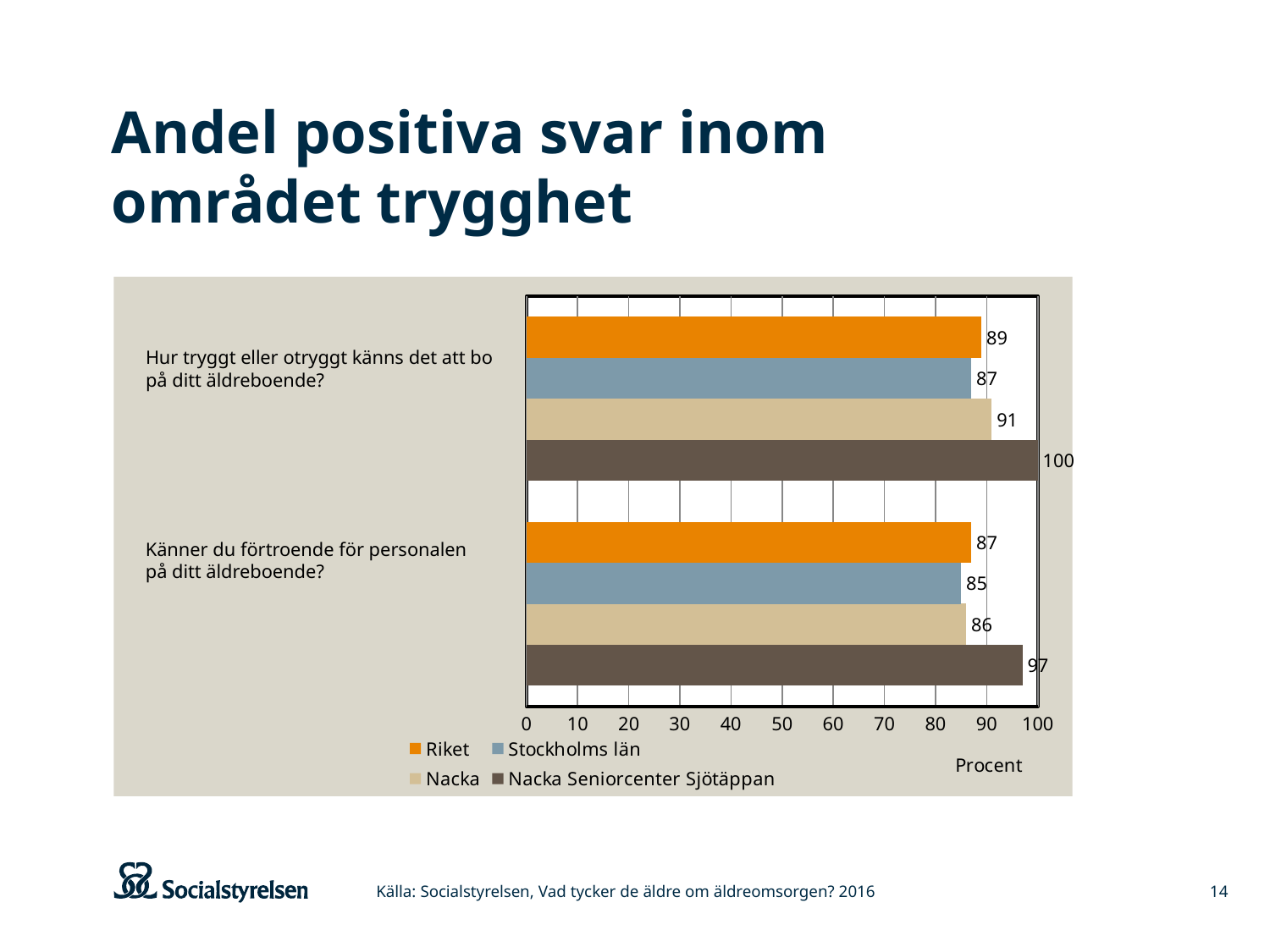
How many series does the legend list? 4 What is the difference between Nacka Seniorcenter Sjötäppan and Riket on the question "Hur tryggt eller otryggt känns det att bo på ditt äldreboende?"? 11 Which series has the lowest value on the question "Känner du förtroende för personalen på ditt äldreboende?"? Stockholms län What is the label of the x axis? Procent What kind of chart is shown on the slide? Bar chart What is the value for Stockholms län on the question "Känner du förtroende för personalen på ditt äldreboende?"? 85 What is the value for Riket on the question "Hur tryggt eller otryggt känns det att bo på ditt äldreboende?"? 89 Which is larger: Riket on "Hur tryggt eller otryggt känns det att bo på ditt äldreboende?" or Riket on "Känner du förtroende för personalen på ditt äldreboende?"? Hur tryggt eller otryggt känns det att bo på ditt äldreboende? What is the value for Nacka Seniorcenter Sjötäppan on the question "Känner du förtroende för personalen på ditt äldreboende?"? 97 What is the difference between Nacka Seniorcenter Sjötäppan and Nacka on the question "Känner du förtroende för personalen på ditt äldreboende?"? 11 Which series has the highest value on the question "Hur tryggt eller otryggt känns det att bo på ditt äldreboende?"? Nacka Seniorcenter Sjötäppan What is the value for Nacka on the question "Hur tryggt eller otryggt känns det att bo på ditt äldreboende?"? 91